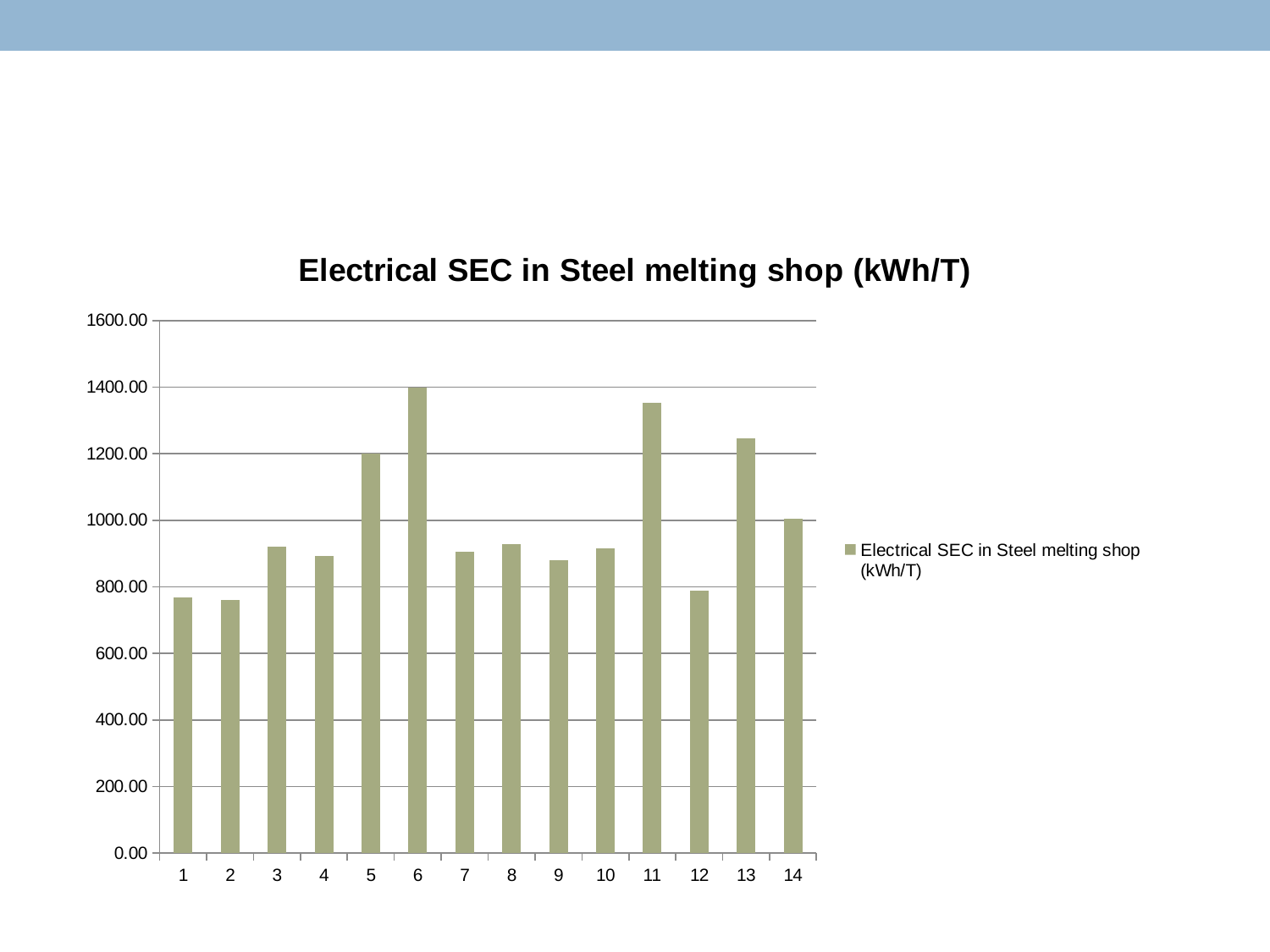
Which is larger, the value for category 11 or the value for category 13? 11 What is the Electrical SEC value for category 6? 1400.00 What kind of chart is shown on the slide? bar chart Is the value for category 9 greater or less than 1000? less What is the title of the chart? Electrical SEC in Steel melting shop (kWh/T) How many categories are plotted along the x axis? 14 Is the value for category 3 greater or less than 800? greater Is the value for category 11 greater or less than 1200? greater How many series does the legend list? 1 Which is larger, the value for category 5 or the value for category 6? 6 Which category has the highest Electrical SEC value? 6